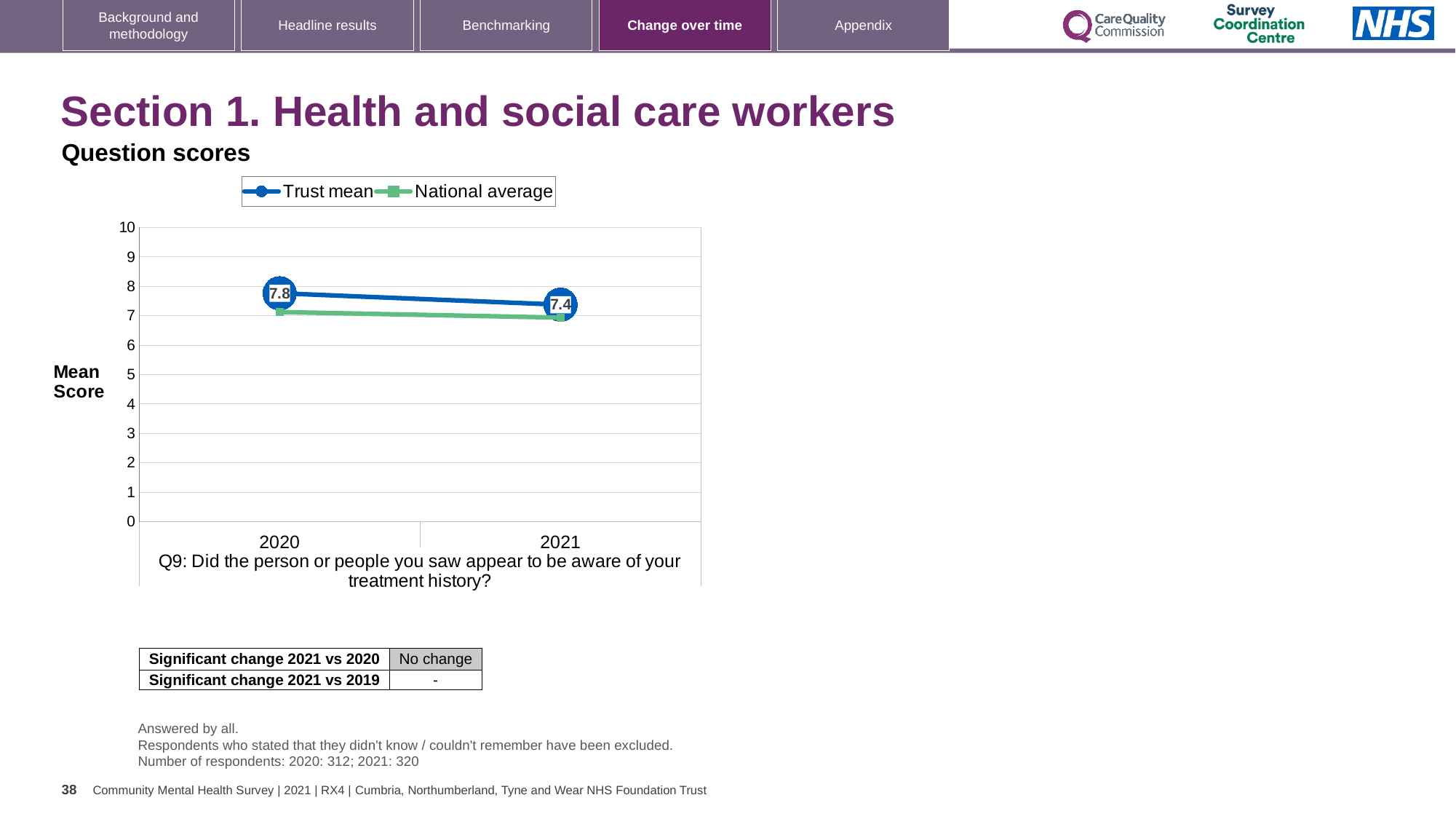
Is the National average for 2021 greater or less than 6? greater How many series does the legend list? 2 Does the Trust mean rise or fall from 2020 to 2021? fall What is the label of the y axis? Mean Score In 2021, which is higher, the Trust mean or the National average? Trust mean What is the Trust mean score for 2020? 7.8 How many years are plotted on the x axis? 2 Which year has the higher Trust mean score, 2020 or 2021? 2020 What kind of chart is shown on the slide? line chart What is the Trust mean score for 2021? 7.4 By how much did the Trust mean score change from 2020 to 2021? 0.4 Is the National average for 2020 greater or less than 8? less